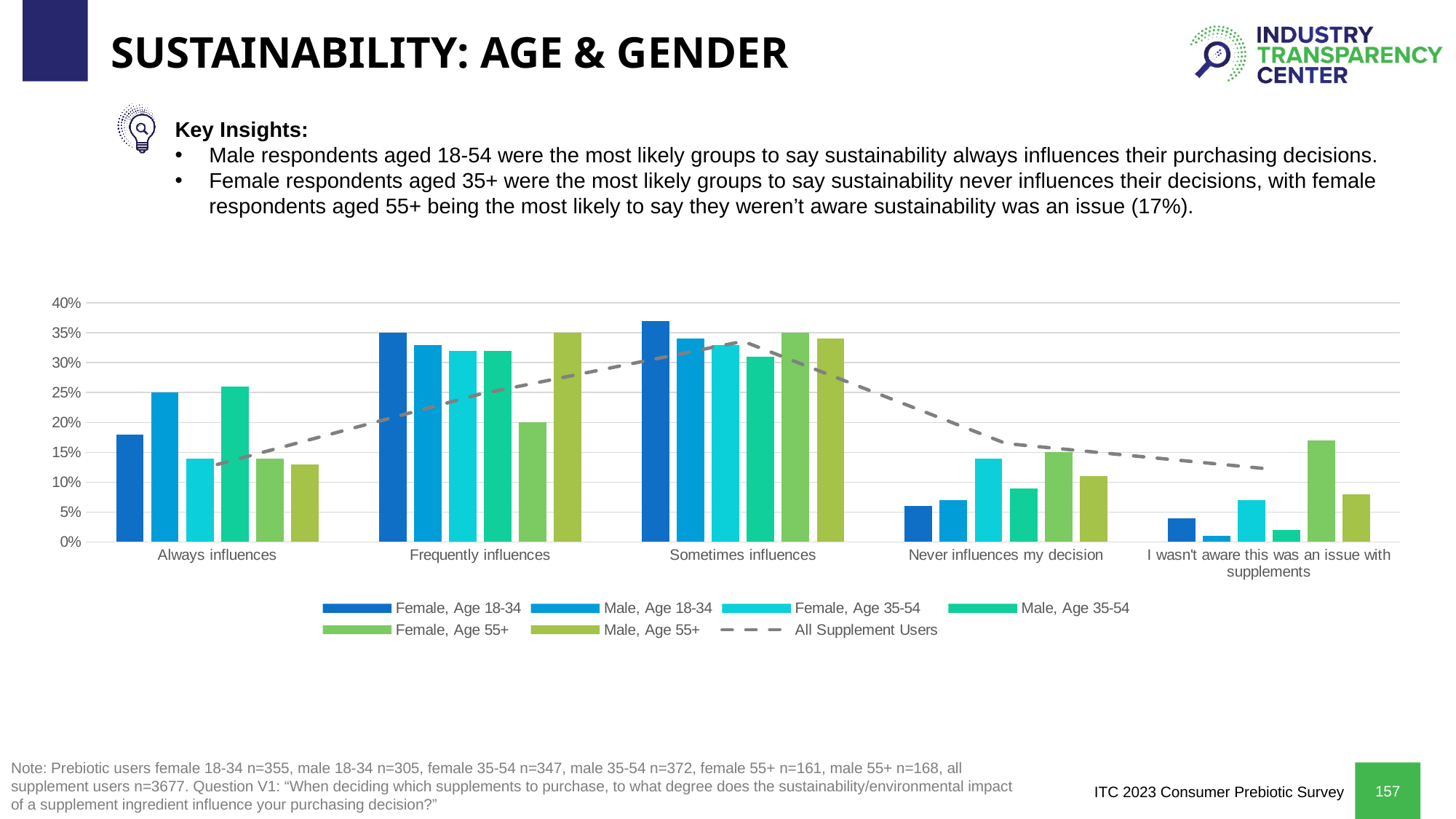
What is the value for Female, Age 18-34 in the 'Frequently influences' category? 35% Is the value for Male, Age 55+ in 'Always influences' greater or less than 15%? less How many response categories are shown along the x axis? 5 Is the value for Female, Age 18-34 in 'Sometimes influences' greater or less than 35%? greater What kind of chart is shown on the slide? Bar chart (with a dashed line series) Which group has the highest value in the 'Sometimes influences' category? Female, Age 18-34 In the 'Frequently influences' category, which is larger: Female, Age 18-34 or Male, Age 35-54? Female, Age 18-34 What is the value for Male, Age 18-34 in the 'Always influences' category? 25% Which group has the lowest value in the 'I wasn't aware this was an issue with supplements' category? Male, Age 18-34 How many series does the legend list? 7 Which group has the highest value in the 'I wasn't aware this was an issue with supplements' category? Female, Age 55+